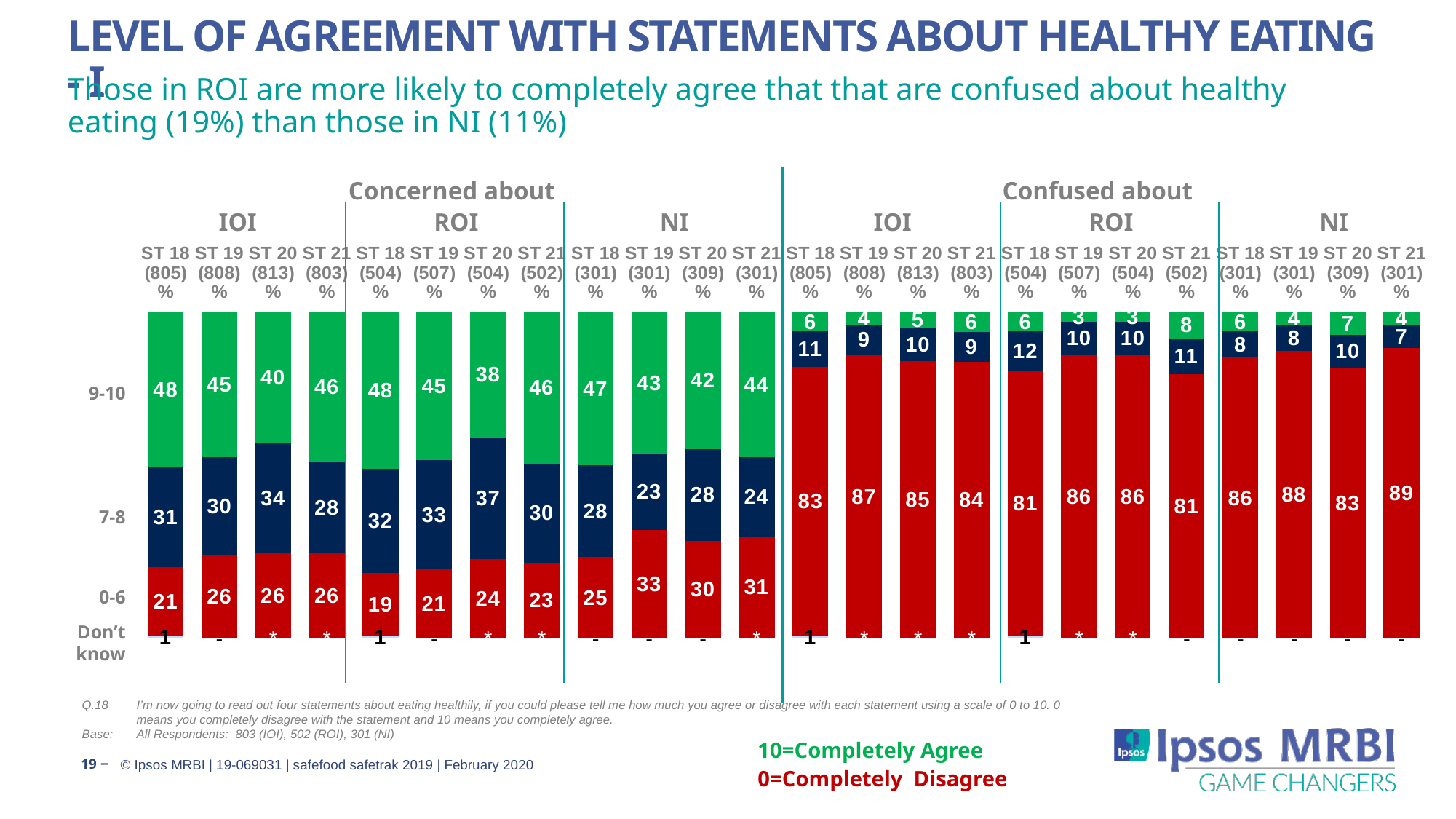
In the 'Confused about' section, what percentage of NI respondents in ST 21 gave a 0-6 rating? 89 In the 'Concerned about' section, what is the difference between the IOI 9-10 percentage in ST 21 and in ST 20? 6 What kind of chart is shown on the slide? Stacked bar chart In the 'Concerned about' section, what is the combined 9-10 and 7-8 percentage for IOI in ST 21? 74 Which colour represents the 9-10 rating in the bars? Green In the 'Confused about' section for ST 18, which has the larger 7-8 percentage: ROI or NI? ROI In the 'Confused about' section, what percentage of IOI respondents in ST 19 gave a 0-6 rating? 87 In the 'Concerned about' section, what percentage of IOI respondents in ST 18 gave a 9-10 rating? 48 How many bars are shown in the 'Concerned about' section? 12 In the 'Concerned about' section, which NI wave has the highest 0-6 percentage? ST 19 In the 'Concerned about' section, does the NI 0-6 percentage rise or fall from ST 18 to ST 19? Rise In the 'Concerned about' section, which ROI wave has the lowest 9-10 percentage? ST 20